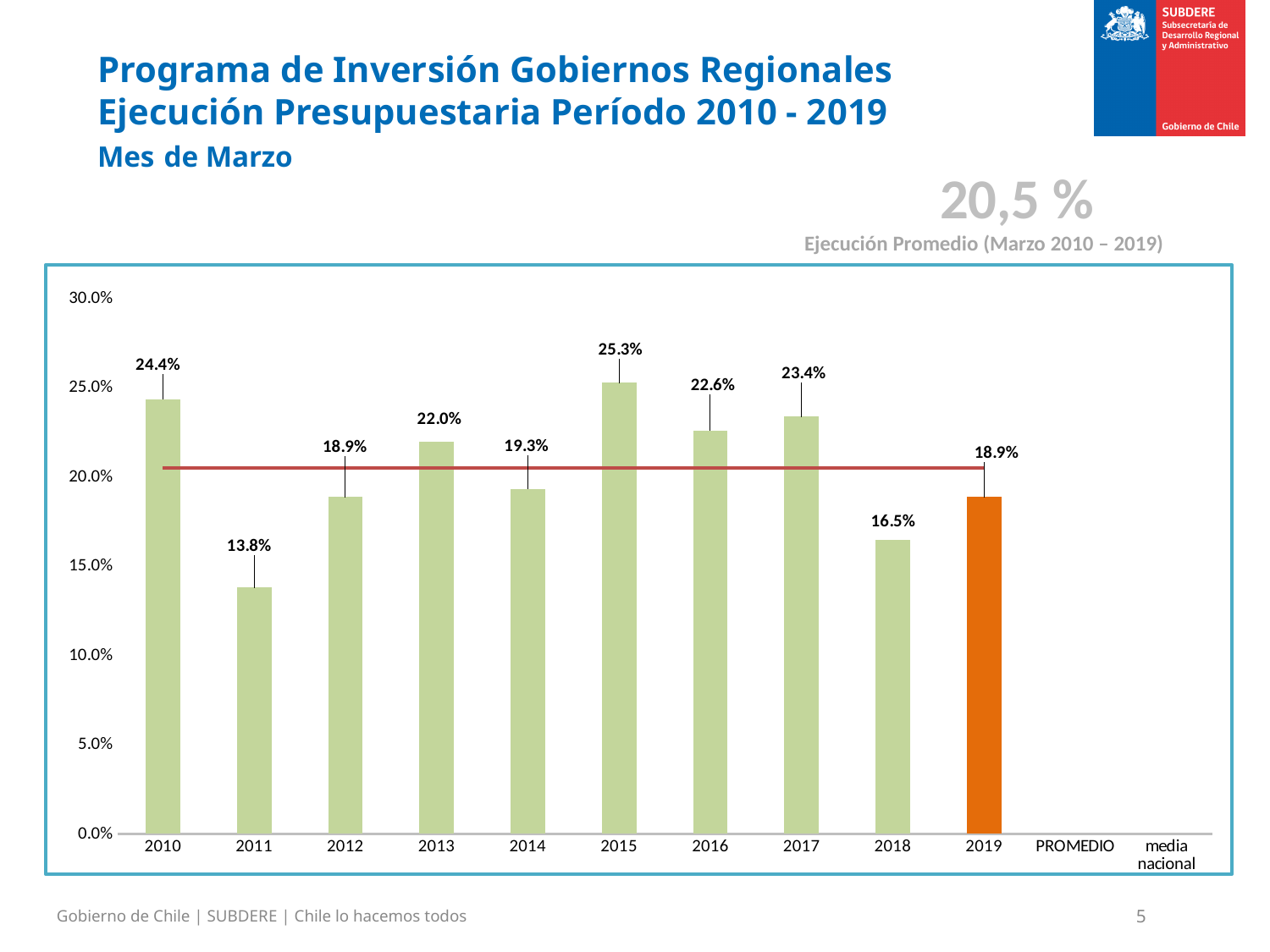
What is the value for 2011? 13.8% How many bars are plotted in the chart? 10 Which year has the highest value? 2015 What kind of chart is shown on the slide? bar chart Is the value for 2014 greater or less than 20.0%? less Which is larger, the value for 2016 or the value for 2017? 2017 Do the values rise or fall from 2017 to 2018? fall Which year has the lowest value? 2011 What is the value for 2019? 18.9% What is the value for 2015? 25.3% Which year's bar is coloured orange instead of green? 2019 What is the difference between the values for 2010 and 2018? 7.9%